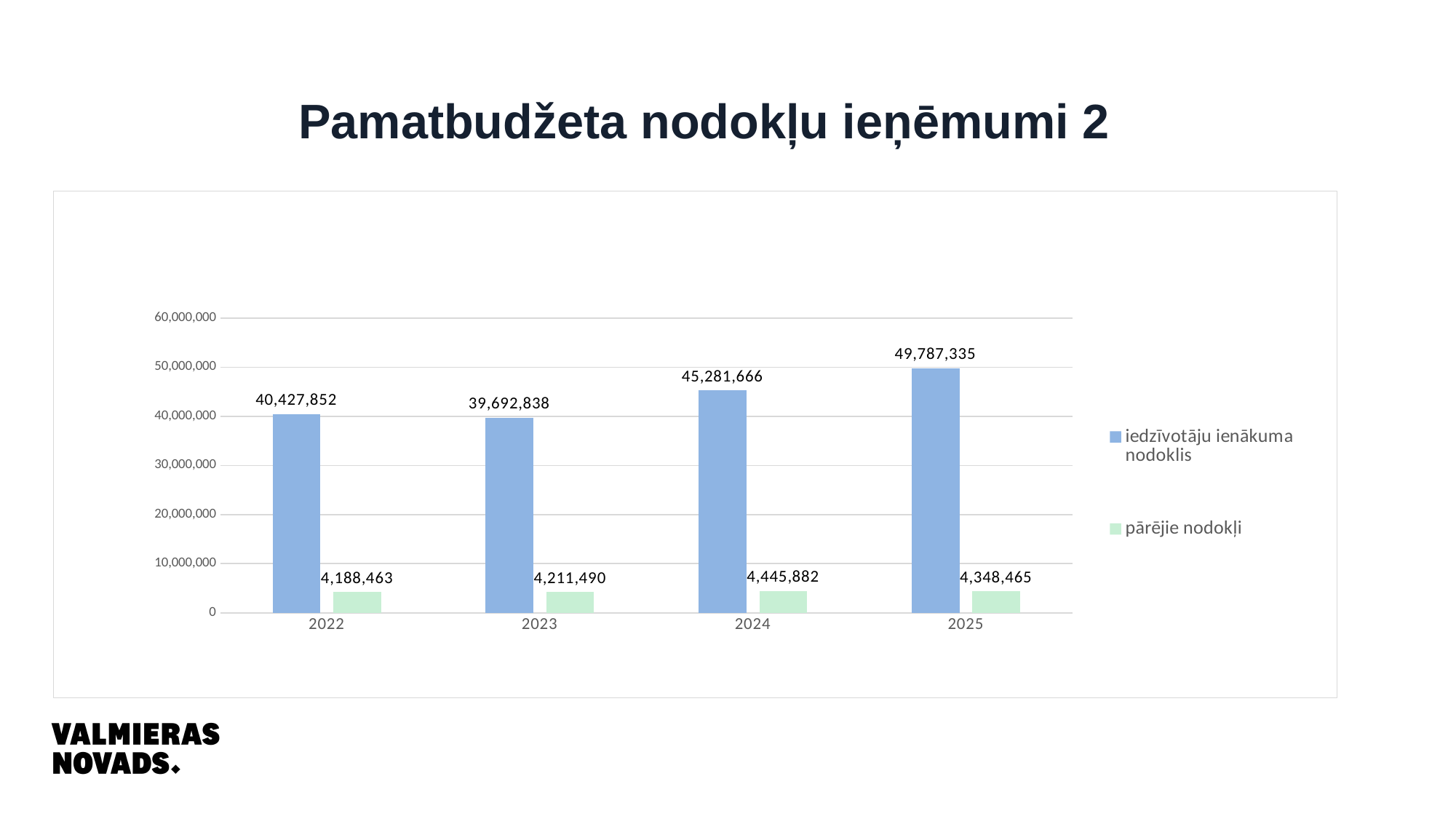
What is the value of pārējie nodokļi for 2023? 4,211,490 What kind of chart is shown on the slide? bar chart In which year is iedzīvotāju ienākuma nodoklis the lowest? 2023 What is the difference between pārējie nodokļi in 2024 and in 2022? 257,419 Which is larger: pārējie nodokļi in 2025 or in 2022? 2025 What is the difference between iedzīvotāju ienākuma nodoklis in 2025 and in 2024? 4,505,669 How many series does the legend list? 2 What is the value of iedzīvotāju ienākuma nodoklis for 2022? 40,427,852 In which year is pārējie nodokļi the highest? 2024 How many years are shown on the x axis? 4 Is the value of iedzīvotāju ienākuma nodoklis for 2024 greater or less than 40,000,000? greater What is the value of iedzīvotāju ienākuma nodoklis for 2025? 49,787,335